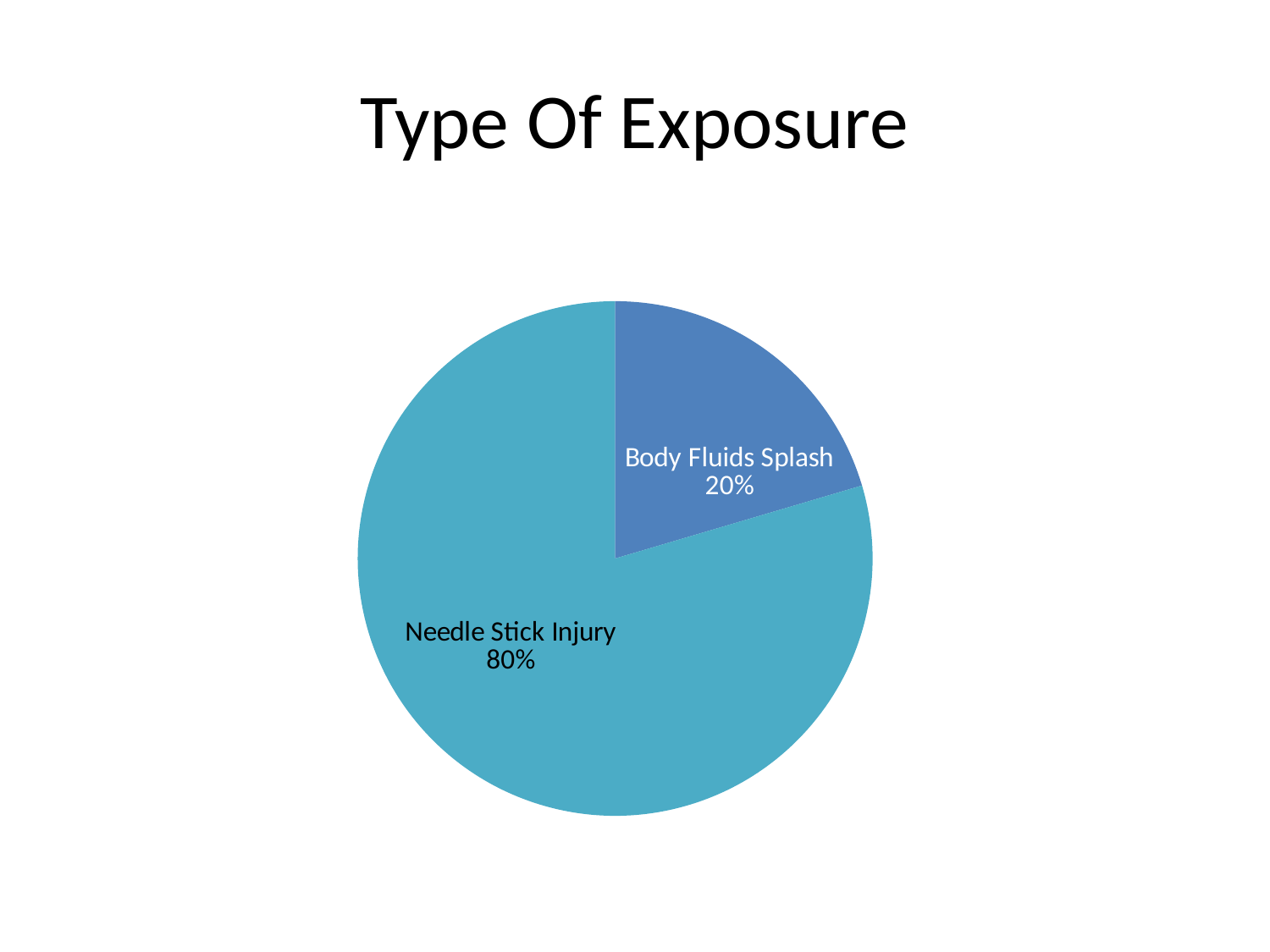
What percentage of exposures is Body Fluids Splash? 20% Which type of exposure has the largest share of the pie? Needle Stick Injury What percentage of exposures is Needle Stick Injury? 80% How many slices does the pie chart have? 2 What is the difference in percentage points between Needle Stick Injury and Body Fluids Splash? 60 What is the title of the chart? Type Of Exposure Which is larger, the share for Needle Stick Injury or the share for Body Fluids Splash? Needle Stick Injury Which type of exposure has the smallest share of the pie? Body Fluids Splash Which slice is shown in the darker blue colour? Body Fluids Splash What type of chart is shown on the slide? pie chart What share of the pie does the Body Fluids Splash slice represent? 20%